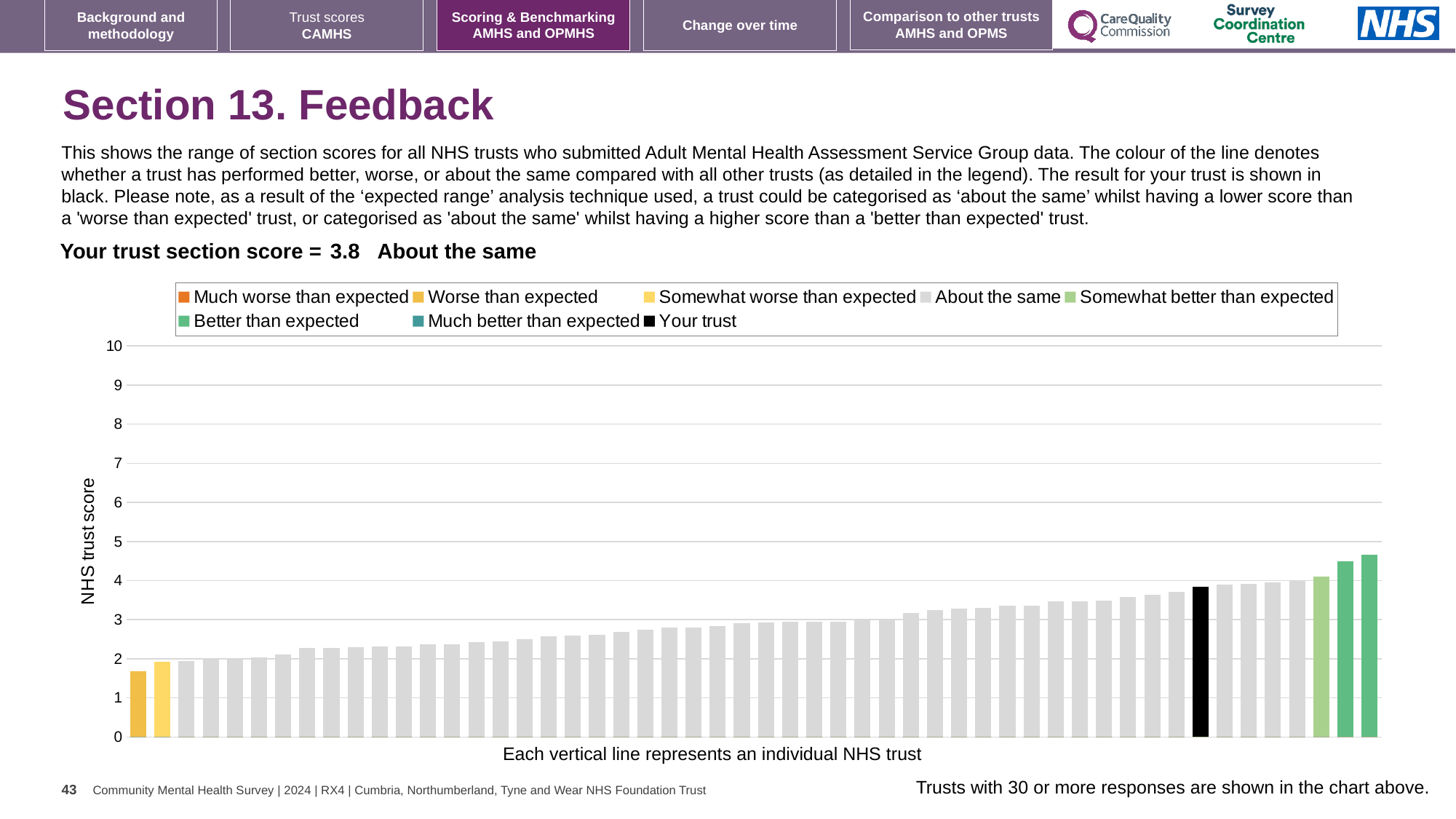
How many entries does the chart legend list? 8 Is the value of the tallest bar in the chart greater or less than 5? less What is the label on the vertical axis of the chart? NHS trust score Which is larger: the rightmost bar or the black 'Your trust' bar? the rightmost bar Which legend category does the shortest bar in the chart belong to? Worse than expected Is the value of the shortest bar in the chart greater or less than 2? less What is the section score for your trust (the black bar)? 3.8 How many bars are coloured as 'Better than expected'? 2 Which legend category does the tallest bar in the chart belong to? Better than expected Do the bar values rise or fall from left to right along the x axis? rise What kind of chart is shown on the slide? bar chart Is the value for your trust (the black bar) greater or less than 3? greater